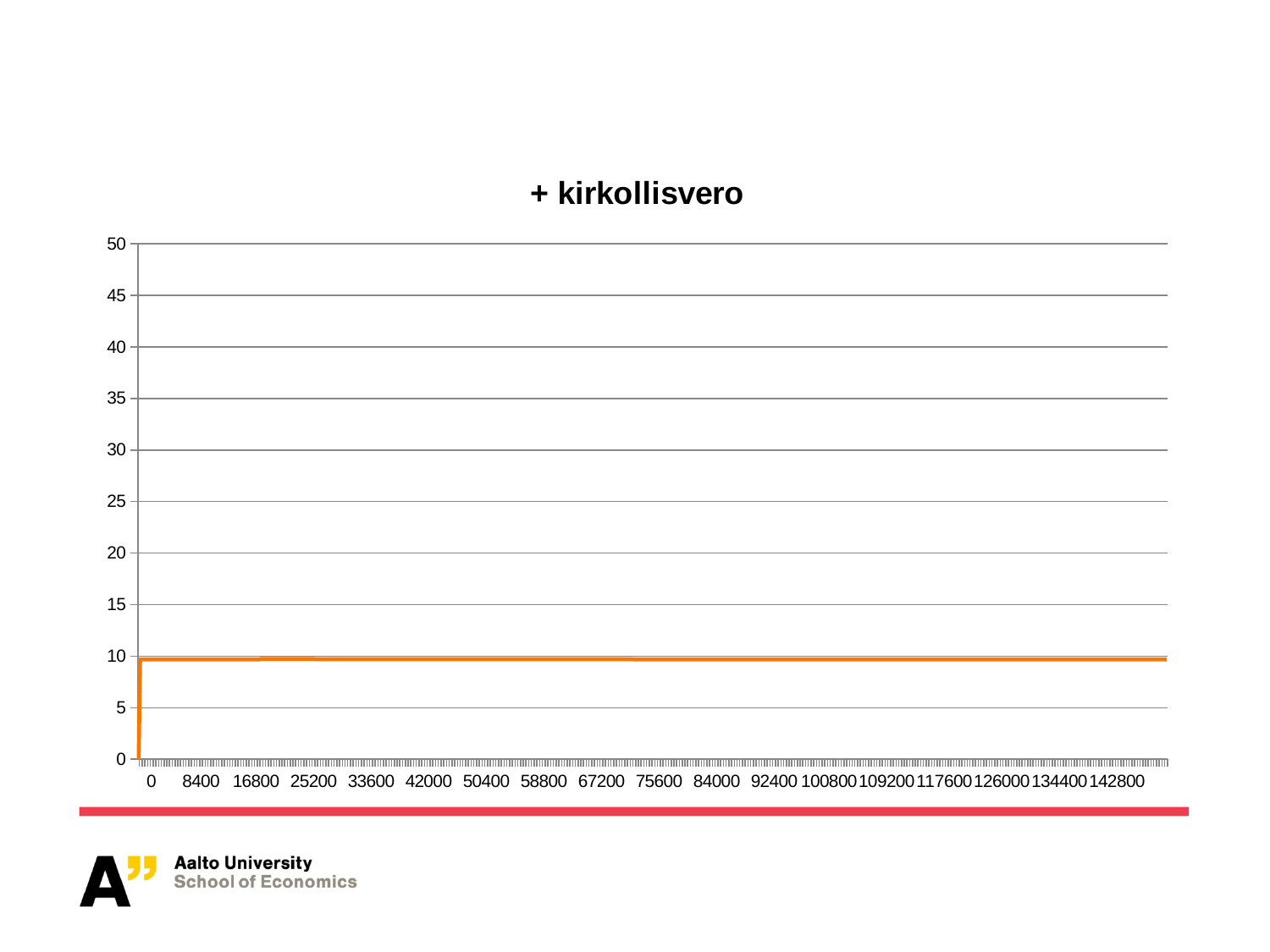
What kind of chart is shown on the slide? line chart What is the title of the chart? + kirkollisvero Is the value for 142800 greater or less than 20? less Is the value for 42000 greater or less than 5? greater What is the step between consecutive y-axis labels? 5 What colour is the plotted line? orange What is the highest value shown on the y axis? 50 How many labelled tick values are shown on the x axis? 18 Is the value for 16800 greater or less than 25? less What is the last labelled value on the x axis? 142800 After the initial jump at 0, does the line rise, fall or stay flat along the x axis? stay flat